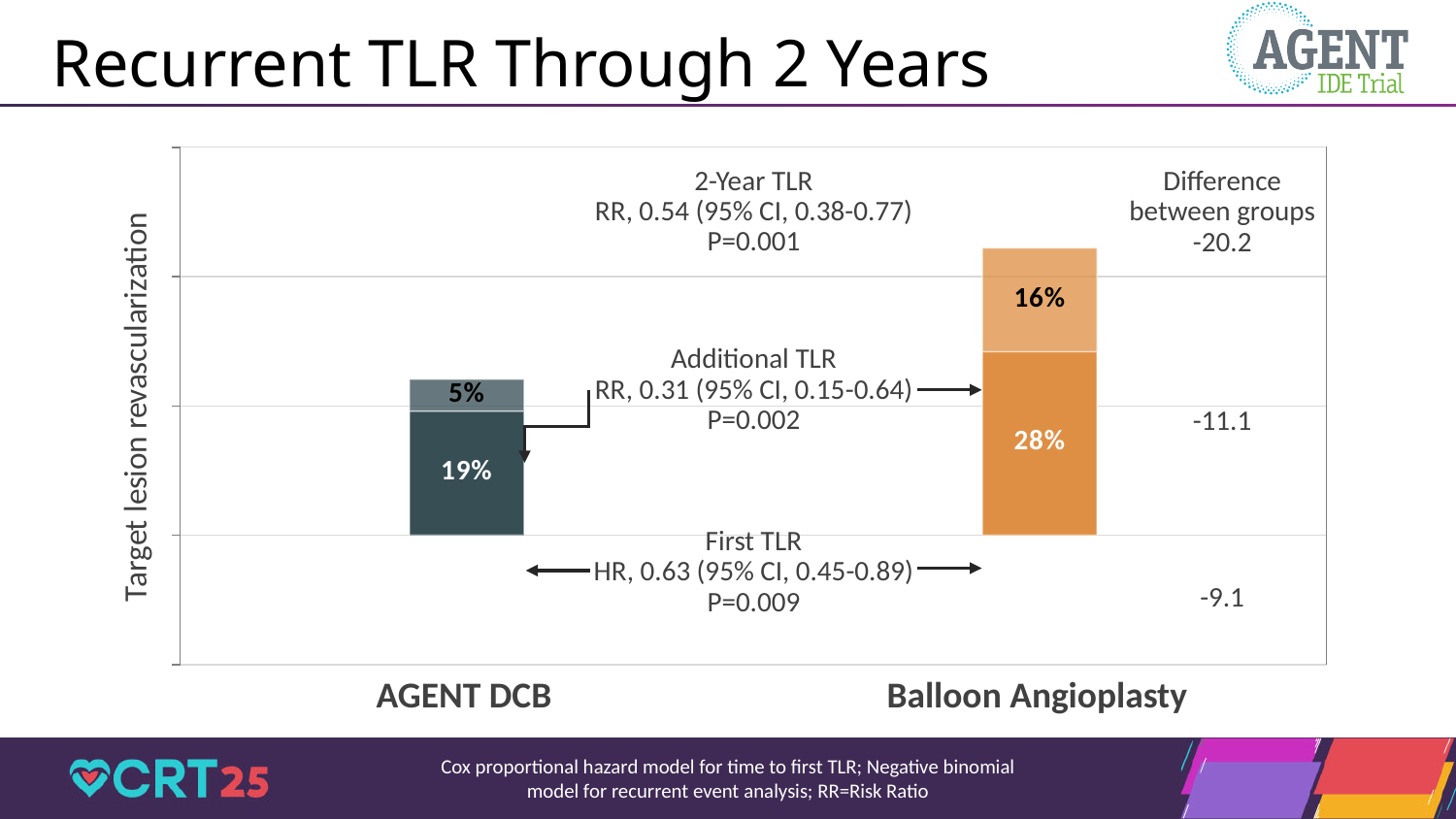
What is the first TLR value (bottom segment) for AGENT DCB? 19% What is the total of the stacked bar for Balloon Angioplasty? 44% What is the first TLR value (bottom segment) for Balloon Angioplasty? 28% How many categories are shown on the x axis of the chart? 2 What is the total of the stacked bar for AGENT DCB? 24% What is the y-axis label of the chart? Target lesion revascularization What is the additional TLR value (top segment) for AGENT DCB? 5% Which category has the taller stacked bar? Balloon Angioplasty What kind of chart is shown on the slide? stacked bar chart What is the difference between the first TLR values of Balloon Angioplasty and AGENT DCB? 9% Which category has the shorter stacked bar? AGENT DCB What is the additional TLR value (top segment) for Balloon Angioplasty? 16%